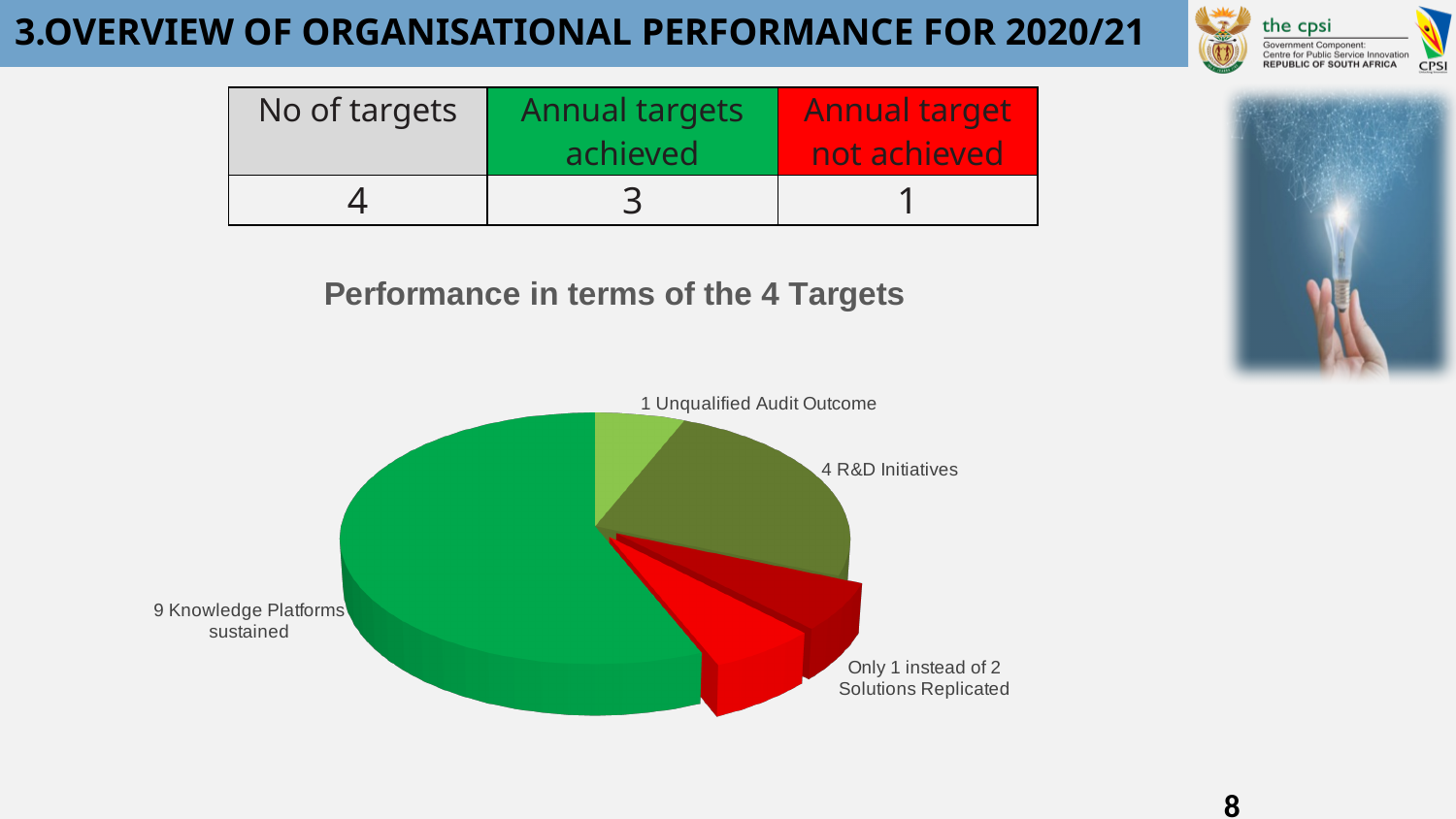
What is the title of the pie chart? Performance in terms of the 4 Targets What kind of chart is shown on the slide? Pie chart Which slice is larger: '9 Knowledge Platforms sustained' or '4 R&D Initiatives'? 9 Knowledge Platforms sustained How many slices does the pie chart have? 5 Which slice of the pie chart is pulled out (exploded) from the rest of the pie? Only 1 instead of 2 Solutions Replicated Which slice is larger: '4 R&D Initiatives' or '1 Unqualified Audit Outcome'? 4 R&D Initiatives Which slice of the pie chart is the largest? 9 Knowledge Platforms sustained What colour is the 'Only 1 instead of 2 Solutions Replicated' slice? Red